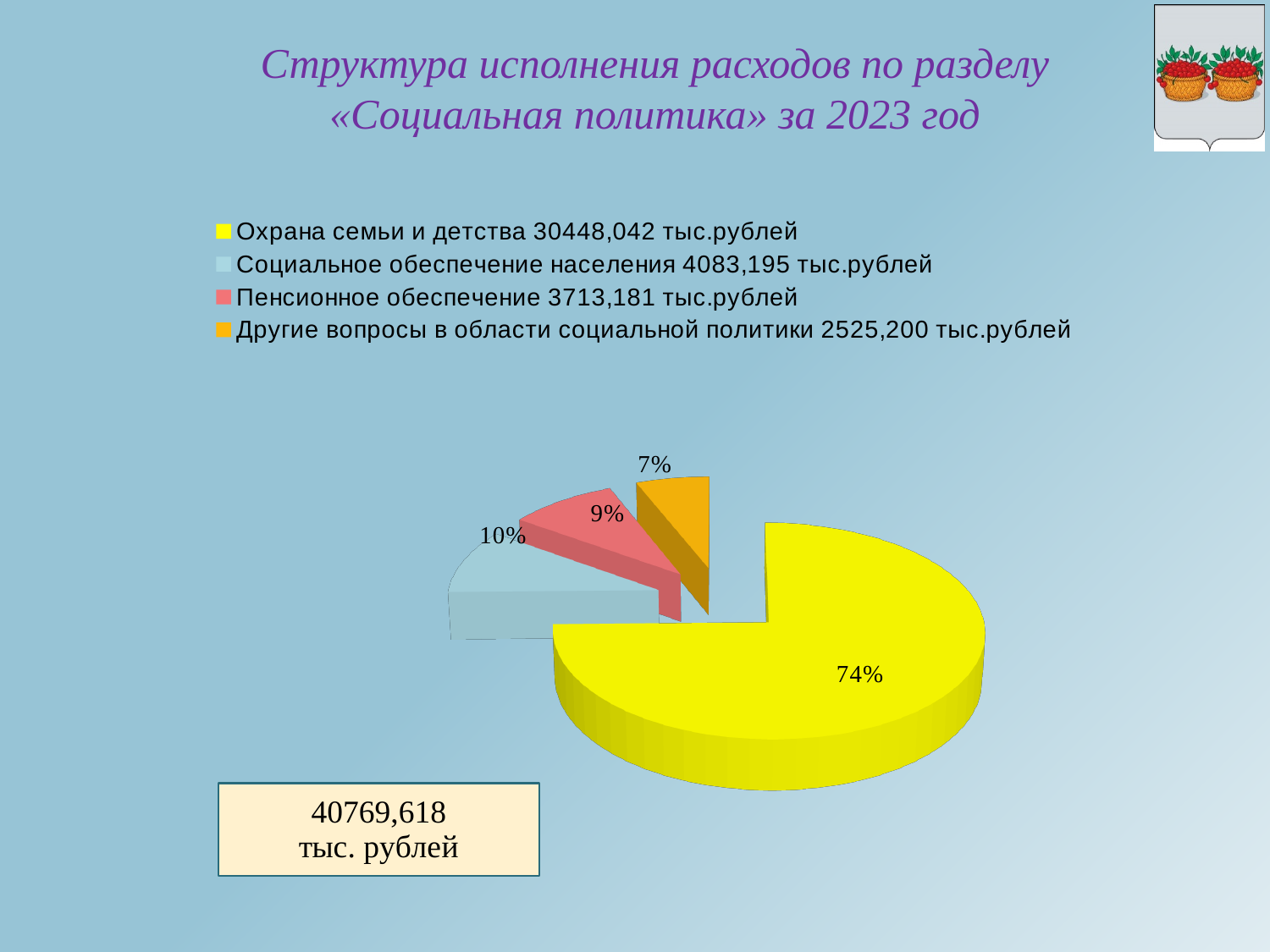
What share of the pie does "Охрана семьи и детства" take? 74% What share of the pie does "Социальное обеспечение населения" take? 10% Which category has the largest slice of the pie? Охрана семьи и детства Which category has the smallest slice of the pie? Другие вопросы в области социальной политики What is the difference in percentage points between the "Охрана семьи и детства" slice and the "Социальное обеспечение населения" slice? 64 percentage points What colour is the slice for "Охрана семьи и детства"? yellow What value in тыс.рублей does the legend give for "Пенсионное обеспечение"? 3713,181 тыс.рублей What kind of chart is shown on the slide? pie chart How many entries does the legend list? 4 How many slices does the pie chart have? 4 What share of the pie does "Пенсионное обеспечение" take? 9%